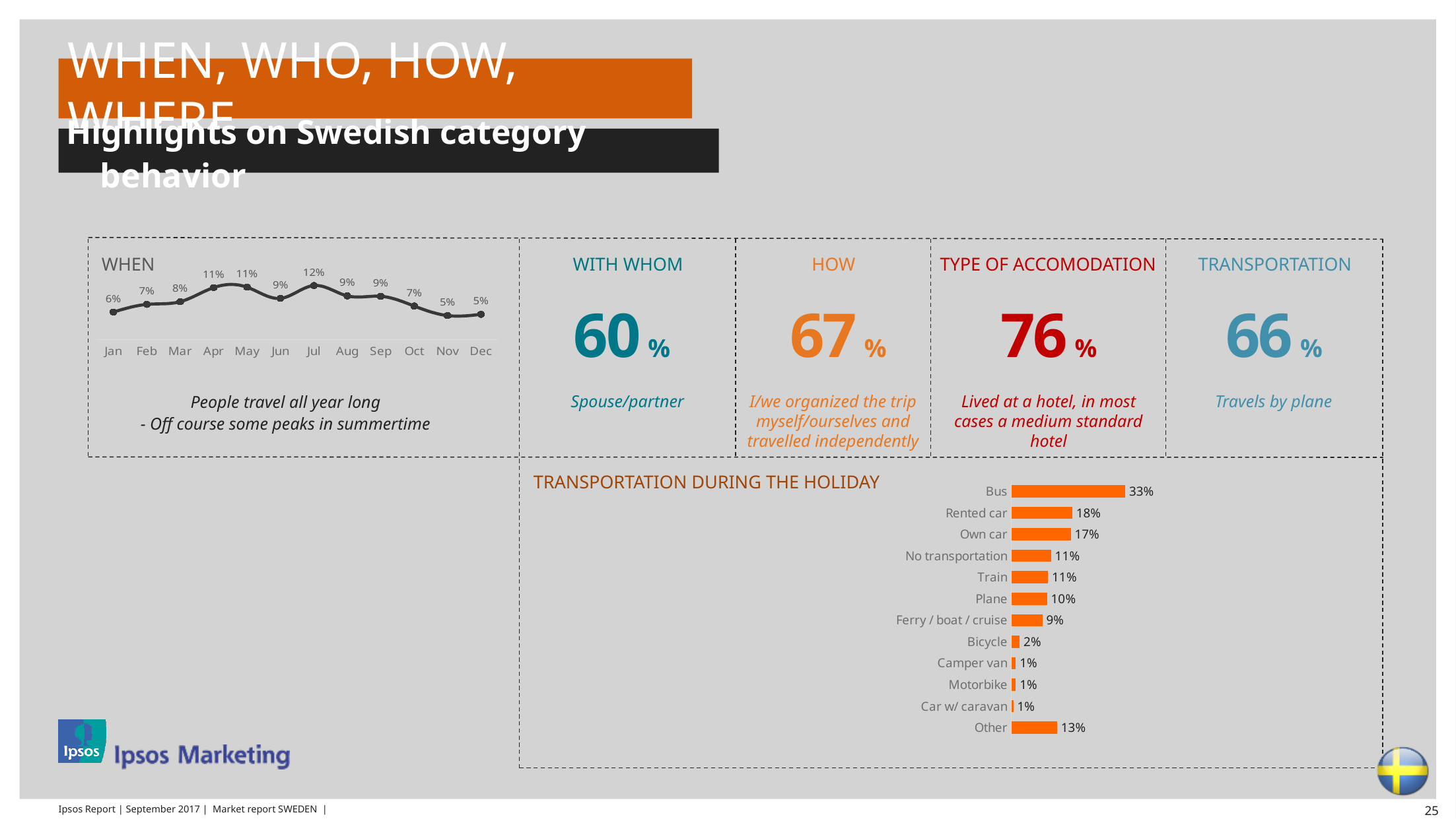
In the WHEN line chart, which month has the highest value? Jul What kind of chart is the WHEN chart? Line chart In the WHEN line chart, what is the value for Jul? 12% In the WHEN line chart, how many months are plotted? 12 In the TRANSPORTATION DURING THE HOLIDAY chart, what is the value for Ferry / boat / cruise? 9% In the TRANSPORTATION DURING THE HOLIDAY chart, which is larger, Rented car or Own car? Rented car In the TRANSPORTATION DURING THE HOLIDAY chart, which category has the highest value? Bus In the TRANSPORTATION DURING THE HOLIDAY chart, what is the difference between Bus and Rented car? 15% In the TRANSPORTATION DURING THE HOLIDAY chart, what is the value for Bus? 33% In the WHEN line chart, what is the difference between the values for Jul and Dec? 7% In the WHEN line chart, what is the value for Jan? 6% What kind of chart is the TRANSPORTATION DURING THE HOLIDAY chart? Bar chart